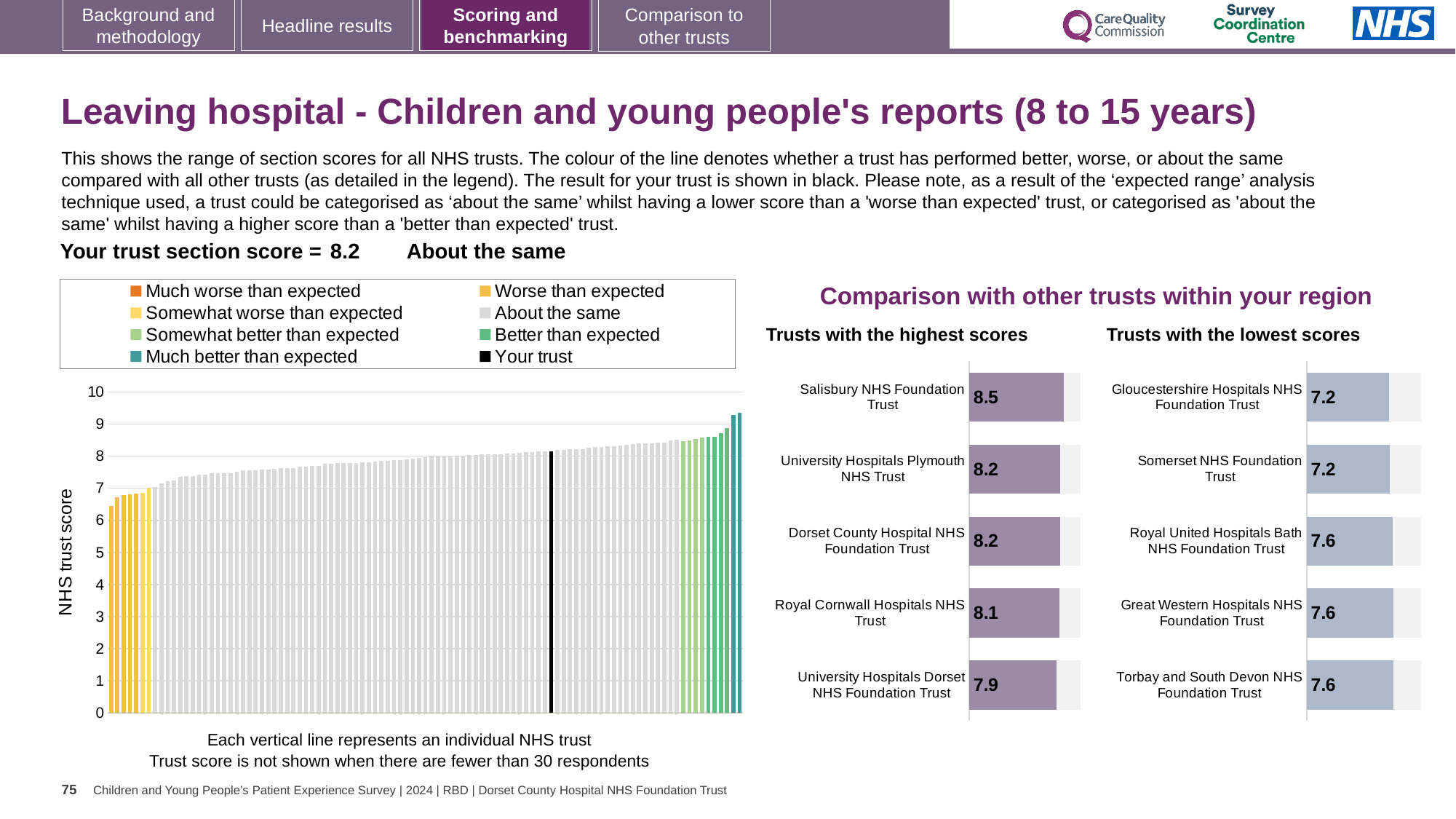
In the 'Trusts with the highest scores' chart, what is the difference between the scores of Salisbury NHS Foundation Trust and University Hospitals Dorset NHS Foundation Trust? 0.6 How many entries does the legend of the main chart on the left list? 8 In the 'Trusts with the highest scores' chart, which trust has the lowest score? University Hospitals Dorset NHS Foundation Trust In the 'Trusts with the highest scores' chart, what is the score for Salisbury NHS Foundation Trust? 8.5 In the 'Trusts with the lowest scores' chart, what is the difference between the scores of Royal United Hospitals Bath NHS Foundation Trust and Gloucestershire Hospitals NHS Foundation Trust? 0.4 In the 'Trusts with the highest scores' chart, which trust has the highest score? Salisbury NHS Foundation Trust How many trusts are shown in the 'Trusts with the lowest scores' chart? 5 In the main chart on the left, do the trust scores rise or fall from left to right? rise Which is larger: the score for Salisbury NHS Foundation Trust in the highest scores chart or the score for Somerset NHS Foundation Trust in the lowest scores chart? Salisbury NHS Foundation Trust In the 'Trusts with the lowest scores' chart, what is the score for Royal United Hospitals Bath NHS Foundation Trust? 7.6 In the main chart on the left showing the range of section scores, is the value of the lowest bar greater or less than 7? less In the 'Trusts with the highest scores' chart, what is the score for University Hospitals Dorset NHS Foundation Trust? 7.9